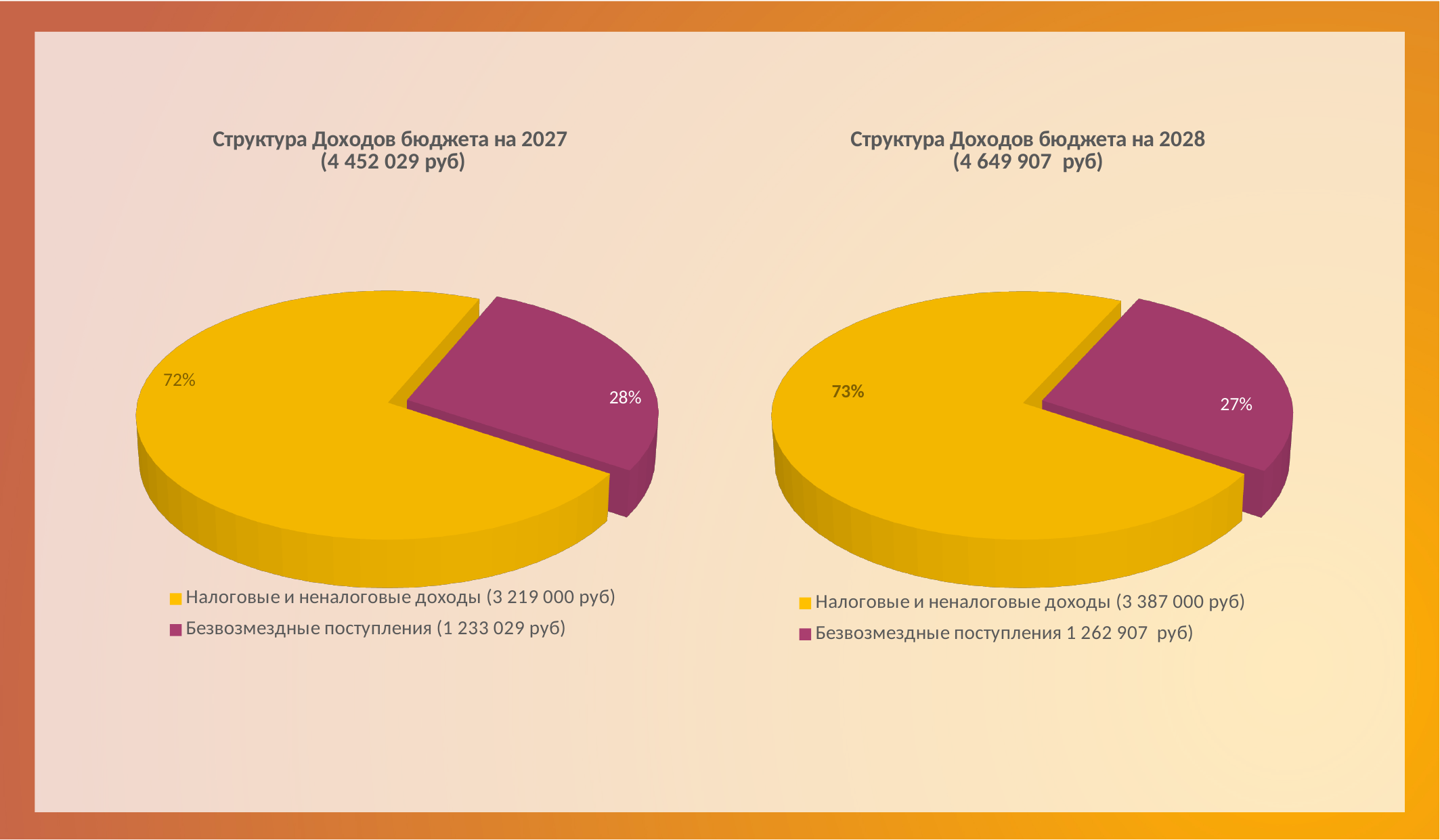
In the chart 'Структура Доходов бюджета на 2027', what share of the pie is 'Безвозмездные поступления'? 28% In the chart 'Структура Доходов бюджета на 2027', what is the difference in percentage points between the two slices? 44 In the chart 'Структура Доходов бюджета на 2028', which is larger: 'Налоговые и неналоговые доходы' or 'Безвозмездные поступления'? Налоговые и неналоговые доходы In the chart 'Структура Доходов бюджета на 2027', which category has the largest slice? Налоговые и неналоговые доходы In the chart 'Структура Доходов бюджета на 2028', what share of the pie is 'Безвозмездные поступления'? 27% What total amount is shown in the title of the chart 'Структура Доходов бюджета на 2028'? 4 649 907 руб In the chart 'Структура Доходов бюджета на 2027', what share of the pie is 'Налоговые и неналоговые доходы'? 72% What kind of chart is 'Структура Доходов бюджета на 2027'? Pie chart In the chart 'Структура Доходов бюджета на 2027', what colour is the 'Безвозмездные поступления' slice? Purple How many categories does the chart 'Структура Доходов бюджета на 2028' show? 2 In the chart 'Структура Доходов бюджета на 2028', which category has the smallest slice? Безвозмездные поступления